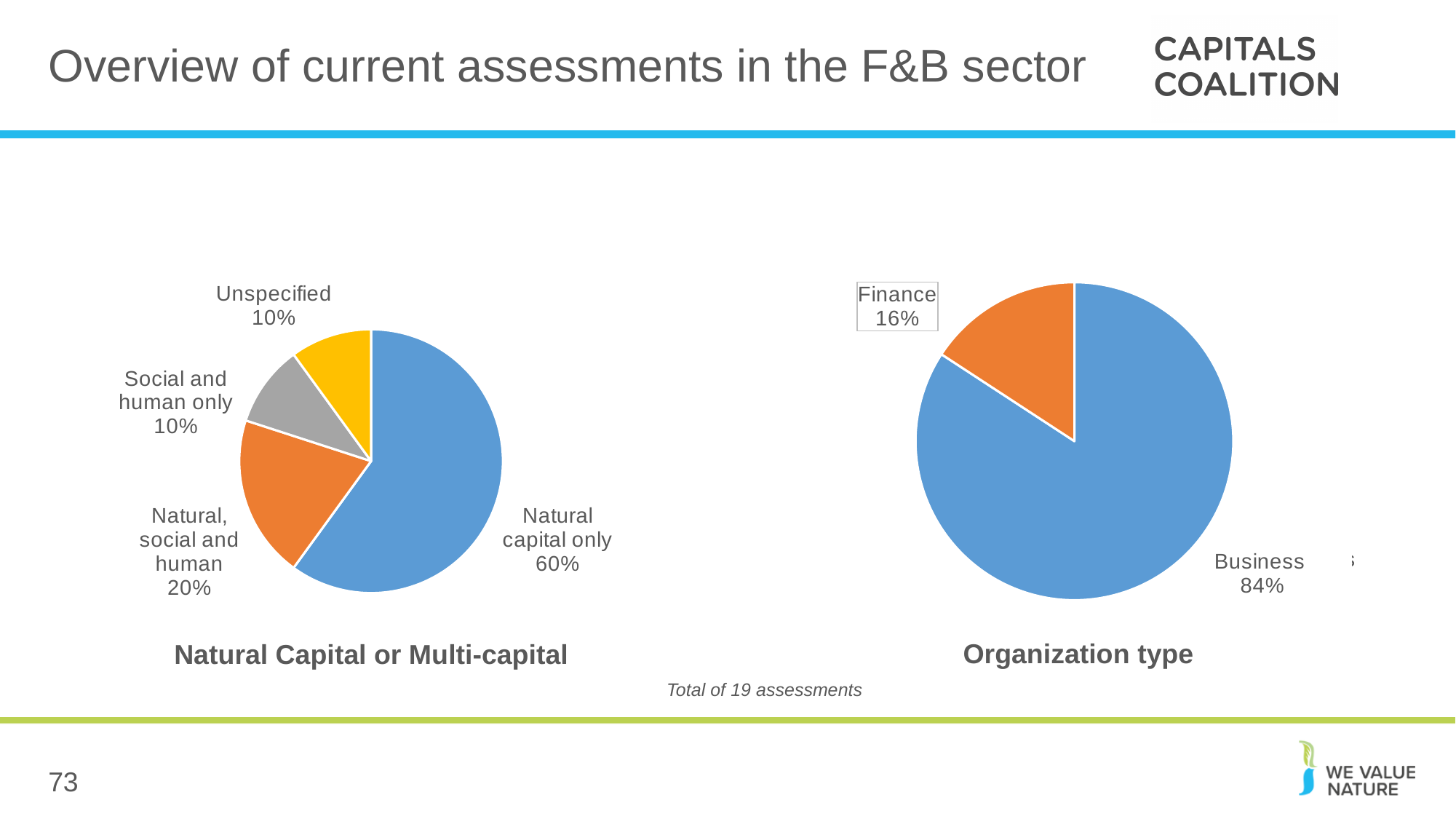
In the 'Natural Capital or Multi-capital' chart, what share is labelled for 'Natural capital only'? 60% In the 'Natural Capital or Multi-capital' chart, how many slices does the pie have? 4 In the 'Natural Capital or Multi-capital' chart, what share is labelled for 'Social and human only'? 10% In the 'Natural Capital or Multi-capital' chart, what is the difference between the 'Natural capital only' share and the 'Natural, social and human' share? 40% According to the note below the charts, how many assessments are covered in total? 19 In the 'Natural Capital or Multi-capital' chart, what share is labelled for 'Natural, social and human'? 20% What kind of chart is the 'Organization type' chart? Pie chart In the 'Organization type' chart, which category has the larger slice, 'Business' or 'Finance'? Business In the 'Organization type' chart, what is the difference between the 'Business' share and the 'Finance' share? 68% In the 'Organization type' chart, what share is labelled for 'Business'? 84% In the 'Natural Capital or Multi-capital' chart, which category has the largest slice? Natural capital only In the 'Organization type' chart, what share is labelled for 'Finance'? 16%